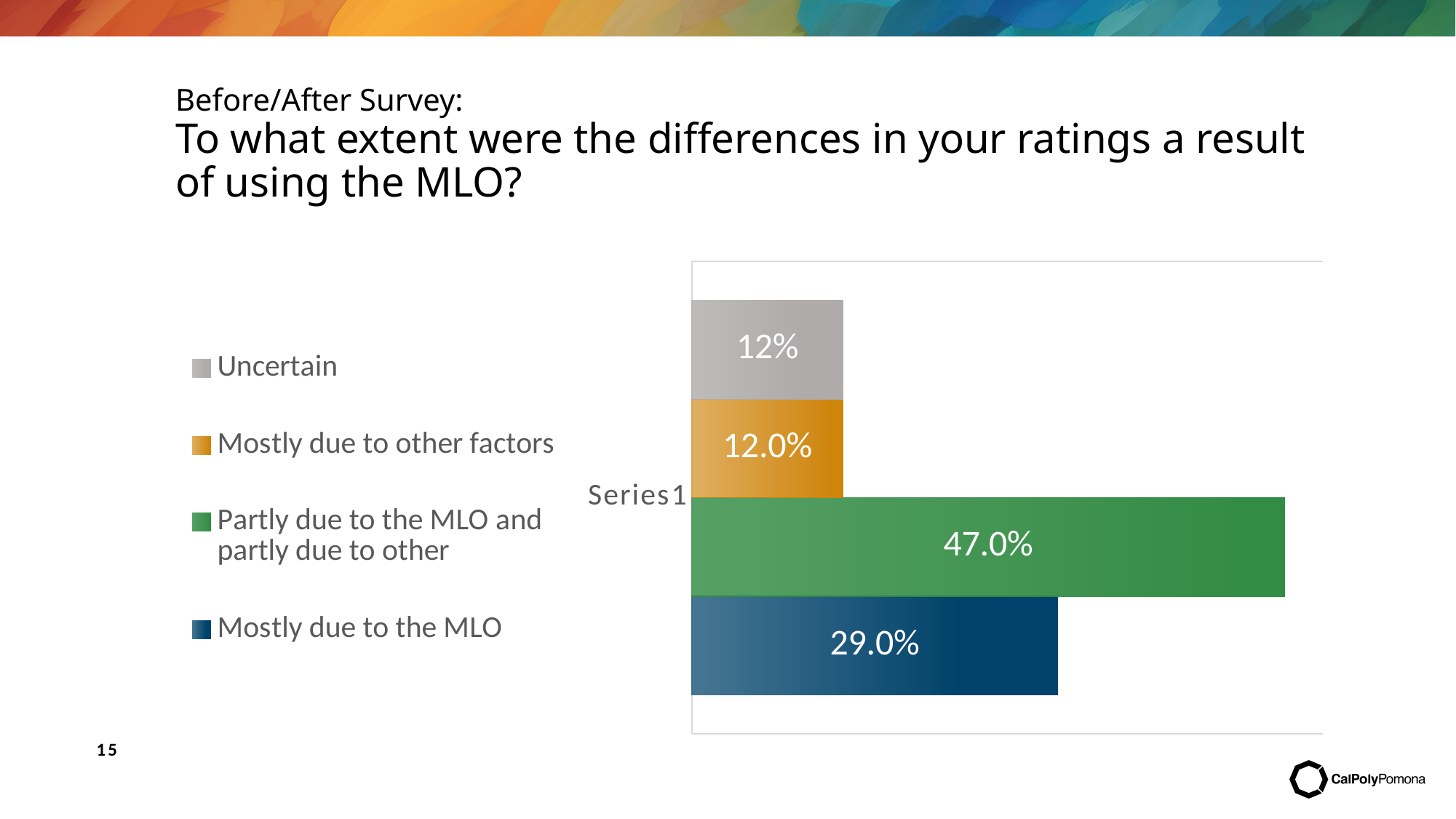
What kind of chart is shown on the slide? Bar chart What is the difference between the values for "Partly due to the MLO and partly due to other" and "Mostly due to the MLO"? 18.0% What is the difference between the values for "Mostly due to the MLO" and "Mostly due to other factors"? 17.0% What value is shown for "Mostly due to the MLO"? 29.0% How many series does the legend list? 4 What value is shown for "Uncertain"? 12% What value is shown for "Partly due to the MLO and partly due to other"? 47.0% What colour is the bar for "Uncertain"? Grey Which legend entry has the highest value? Partly due to the MLO and partly due to other Which is larger, the value for "Mostly due to the MLO" or the value for "Mostly due to other factors"? Mostly due to the MLO What value is shown for "Mostly due to other factors"? 12.0% What is the category label shown on the axis of the chart? Series1